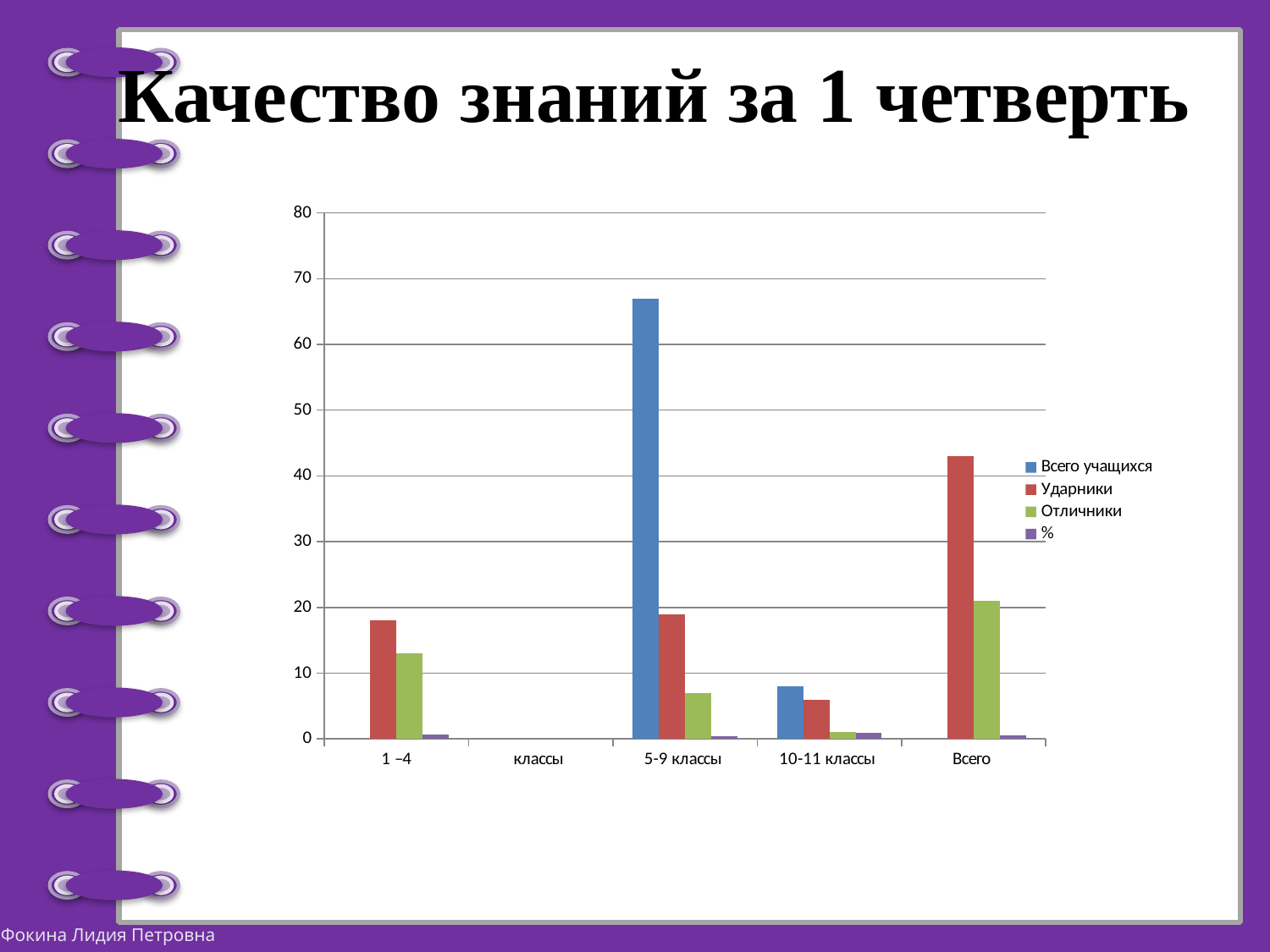
For '1 –4', which is larger: 'Ударники' or 'Отличники'? Ударники Is the value of 'Отличники' for '5-9 классы' greater or less than 10? less Which category has the tallest 'Ударники' bar? Всего Is the value of 'Всего учащихся' for '10-11 классы' greater or less than 10? less Is the value of 'Ударники' for 'Всего' greater or less than 40? greater Which category has the tallest 'Всего учащихся' bar? 5-9 классы How many series does the legend list? 4 What is the title of the slide with the chart? Качество знаний за 1 четверть What kind of chart is shown on the slide? bar chart Which colour represents the series 'Ударники' in the legend? red